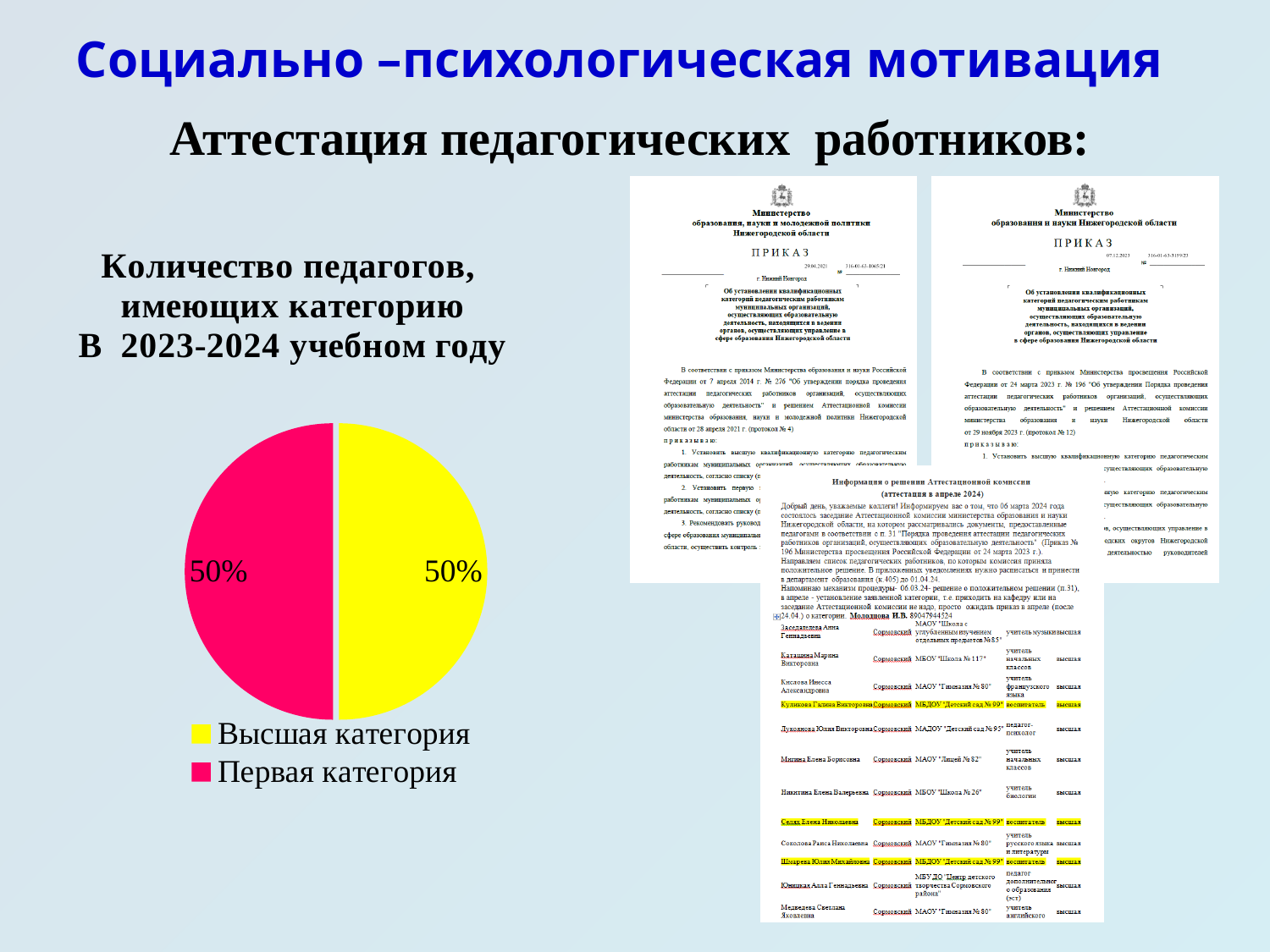
How many entries does the legend of the pie chart list? 2 What share of the pie does the Первая категория slice take? 50% What percentage is shown for Первая категория in the pie chart? 50% What share of the pie does the Высшая категория slice take? 50% Which legend entry is shown in pink (magenta) in the pie chart? Первая категория What kind of chart is shown on the slide? pie chart What percentage is shown for Высшая категория in the pie chart? 50% What colour is the Высшая категория slice in the pie chart? yellow How many slices does the pie chart have? 2 What is the difference between the percentages for Высшая категория and Первая категория? 0%